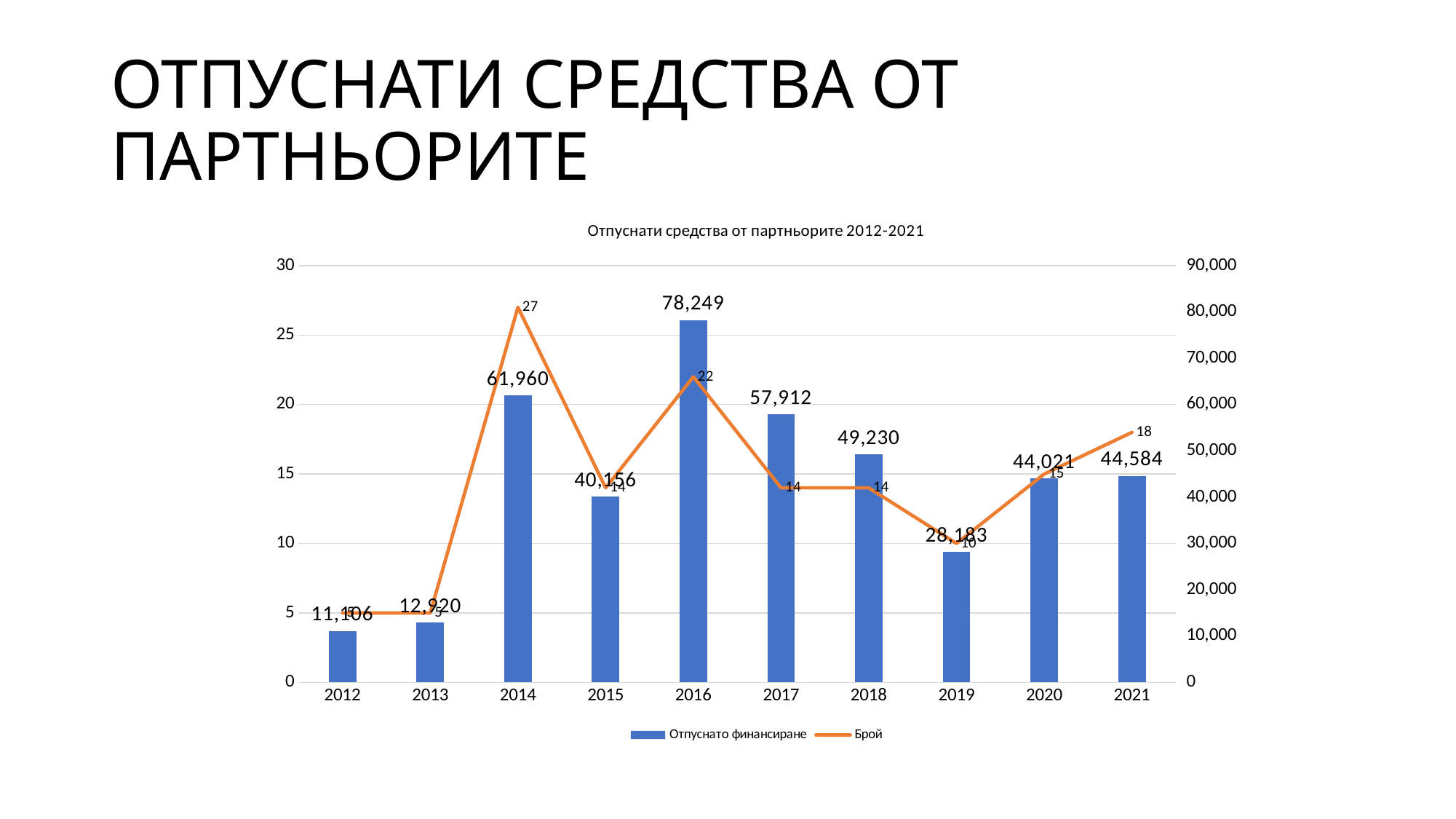
Which year has the lowest Отпуснато финансиране? 2012 What is the difference in Отпуснато финансиране between 2016 and 2017? 20,337 What is the value of Отпуснато финансиране for 2019? 28,183 What is the value of Отпуснато финансиране for 2016? 78,249 What is the title of the chart? Отпуснати средства от партньорите 2012-2021 Does the Отпуснато финансиране value rise or fall from 2016 to 2019? fall What is the Брой value for 2021? 18 Which year has the larger Отпуснато финансиране, 2014 or 2018? 2014 Which year has the highest Отпуснато финансиране? 2016 What is the Брой value for 2014? 27 How many years are shown on the x axis? 10 How many series does the legend list? 2